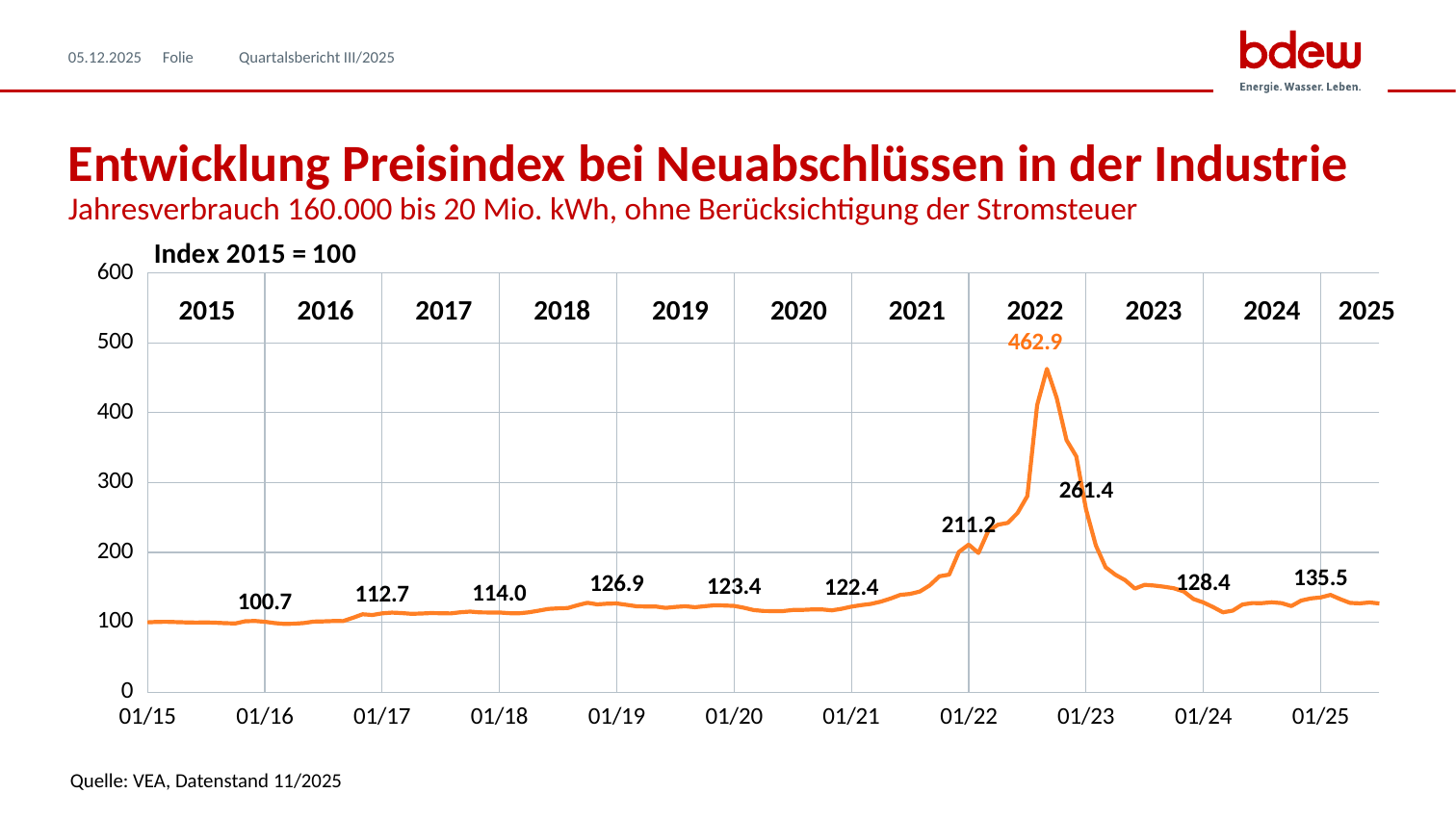
What is the last data label on the line, around 2024/2025? 135.5 Which labeled value is larger, 126.9 or 123.4? 126.9 What kind of chart is shown on the slide? line chart What is the data label shown just after the 2022 peak, around the start of 2023? 261.4 What is the lowest labeled value on the line? 100.7 What is the difference between the labeled values 135.5 and 128.4? 7.1 What is the highest labeled value on the line? 462.9 Is the value at 01/15 greater or less than 200? less What is the difference between the peak value 462.9 and the following labeled value 261.4? 201.5 How many year labels (2015 to 2025) are shown across the top of the chart? 11 What is the data label shown just before the 2022 peak, around the start of 2022? 211.2 What base is stated for the index in the chart's label? Index 2015 = 100